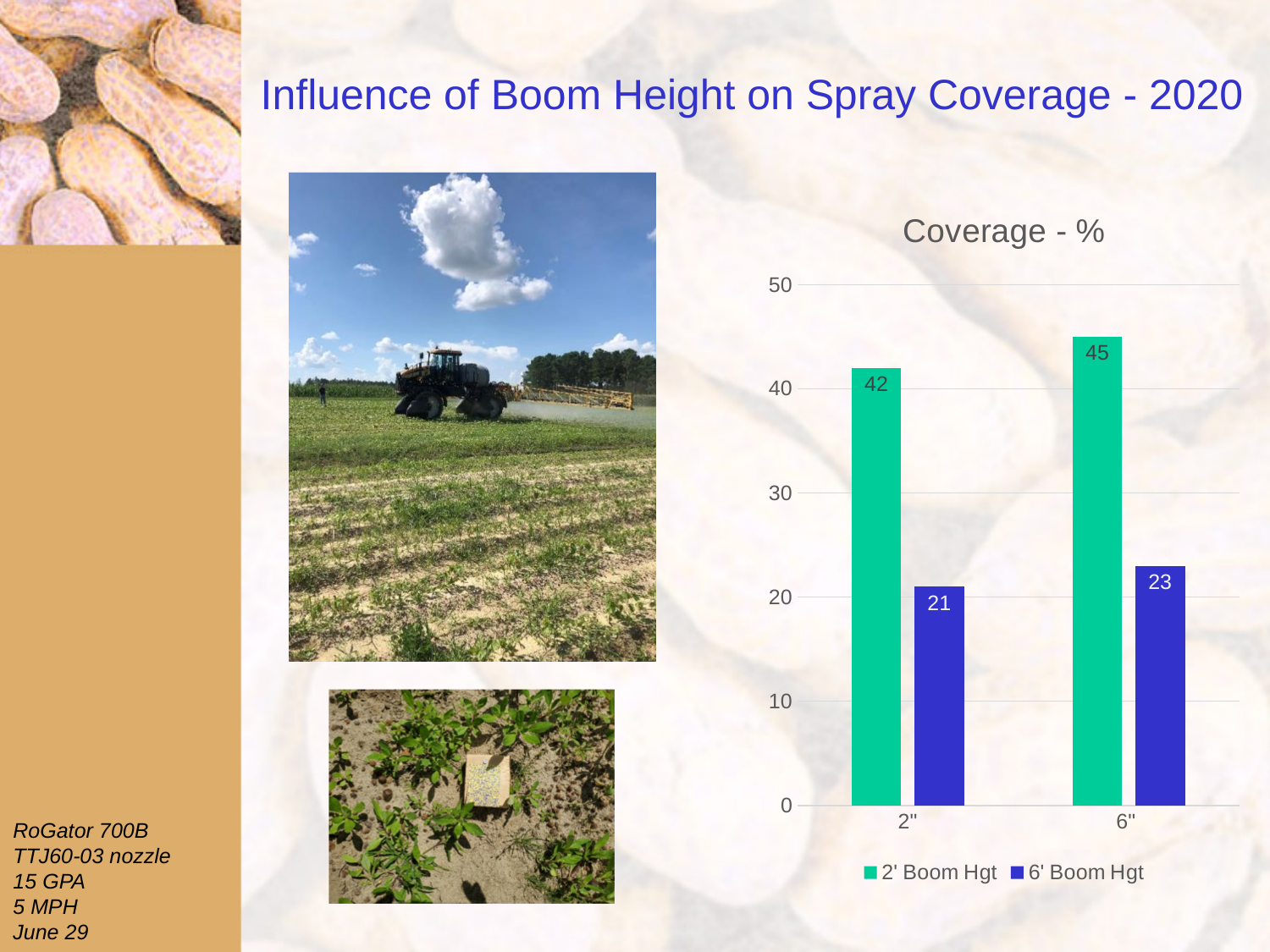
What is the coverage value for 6' Boom Hgt at the 6" category? 23 What type of chart is shown on the slide? bar chart How many series does the legend list? 2 Which bar has the highest value in the chart? 2' Boom Hgt at 6" What is the chart's title? Coverage - % How many categories are shown on the x axis? 2 What is the coverage value for 2' Boom Hgt at the 2" category? 42 Which bar has the lowest value in the chart? 6' Boom Hgt at 2" Which series is larger at the 2" category, 2' Boom Hgt or 6' Boom Hgt? 2' Boom Hgt What is the difference between the 2' Boom Hgt and 6' Boom Hgt values at the 6" category? 22 What is the coverage value for 6' Boom Hgt at the 2" category? 21 What is the coverage value for 2' Boom Hgt at the 6" category? 45